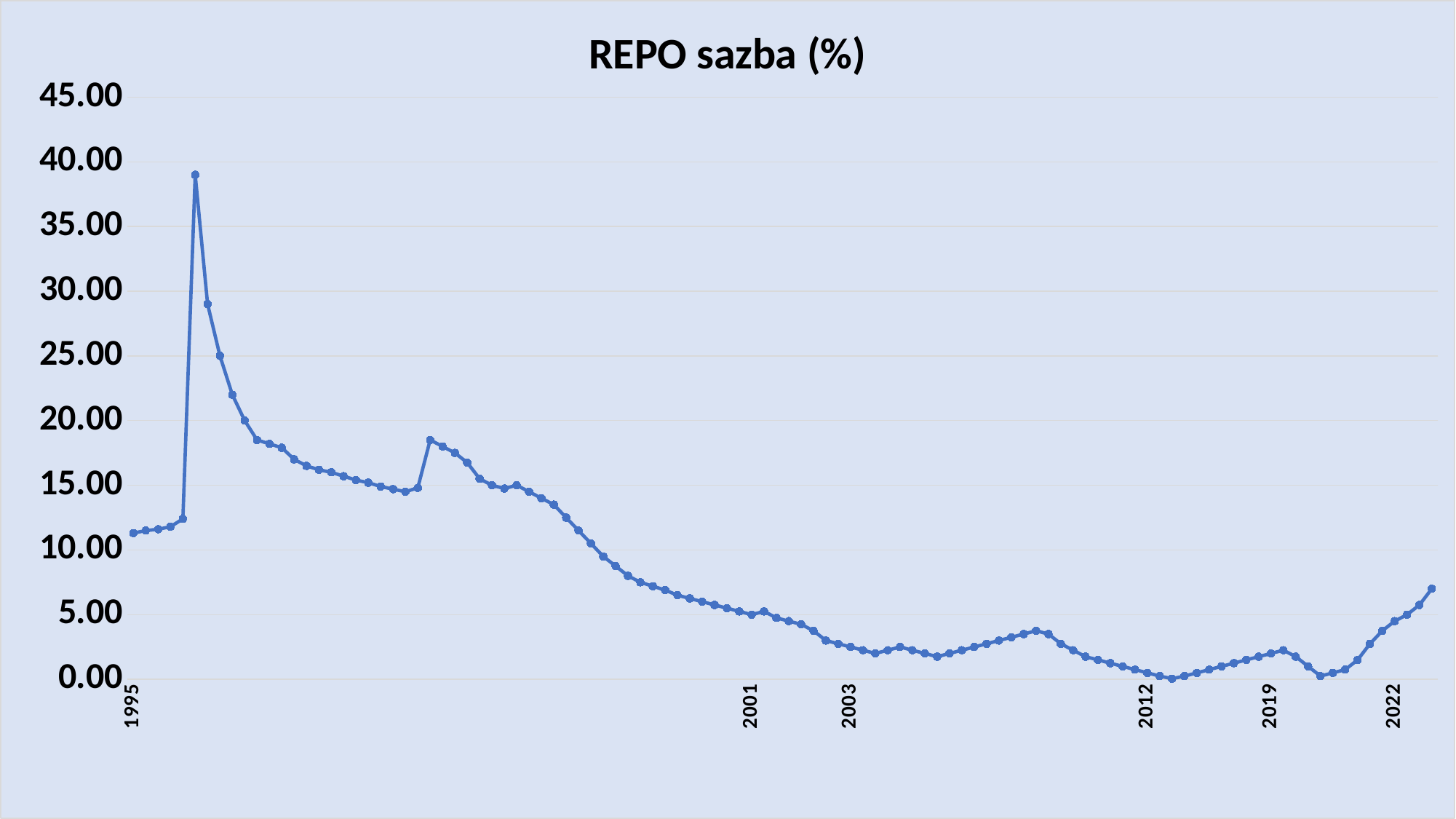
Is the value for 2003 greater or less than 5? less Is the value for 2001 greater or less than 10? less What is the highest tick value shown on the vertical axis? 45.00 Is the value for 2012 greater or less than 5? less What is the title of the chart? REPO sazba (%) How many lines (series) are plotted on the chart? 1 What kind of chart is shown on the slide? line chart Which is larger, the value for 1995 or the value for 2022? 1995 Which is larger, the value for 2001 or the value for 2003? 2001 Overall, do the values rise or fall from 1995 to 2022? fall